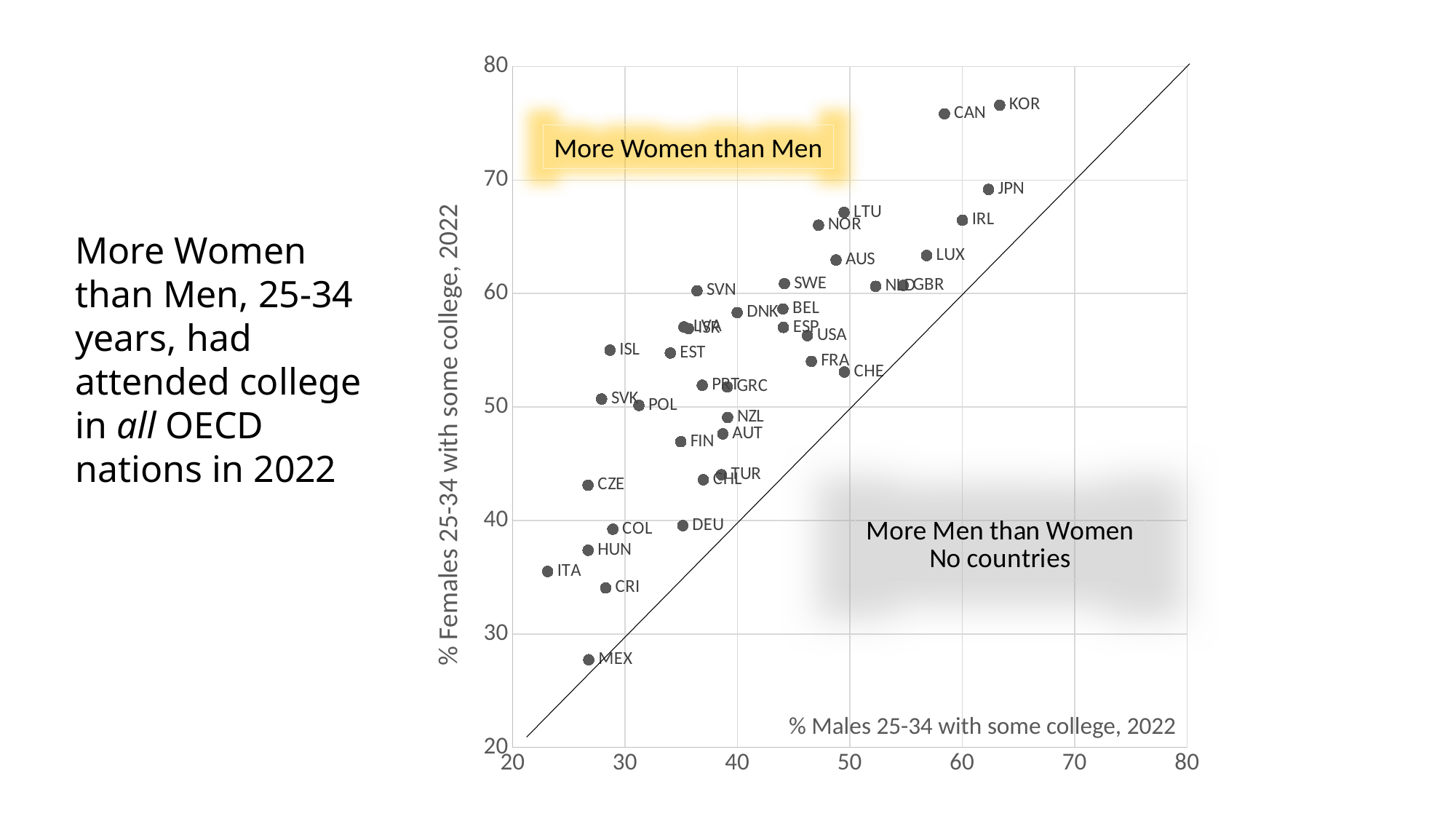
Is the % Males value for JPN greater or less than 60? greater Which country has a higher % Males value, JPN or ITA? JPN Which country has the lowest value on the y axis (% Females 25-34 with some college)? MEX Which country has a higher % Females value, CAN or MEX? CAN What is the title of the x axis? % Males 25-34 with some college, 2022 What is the title of the y axis? % Females 25-34 with some college, 2022 Is the % Females value for KOR greater or less than 70? greater What kind of chart is shown on the slide? Scatter plot Which country has the highest value on the x axis (% Males 25-34 with some college)? KOR Which country has the lowest value on the x axis (% Males 25-34 with some college)? ITA Is the % Females value for NOR greater or less than 60? greater